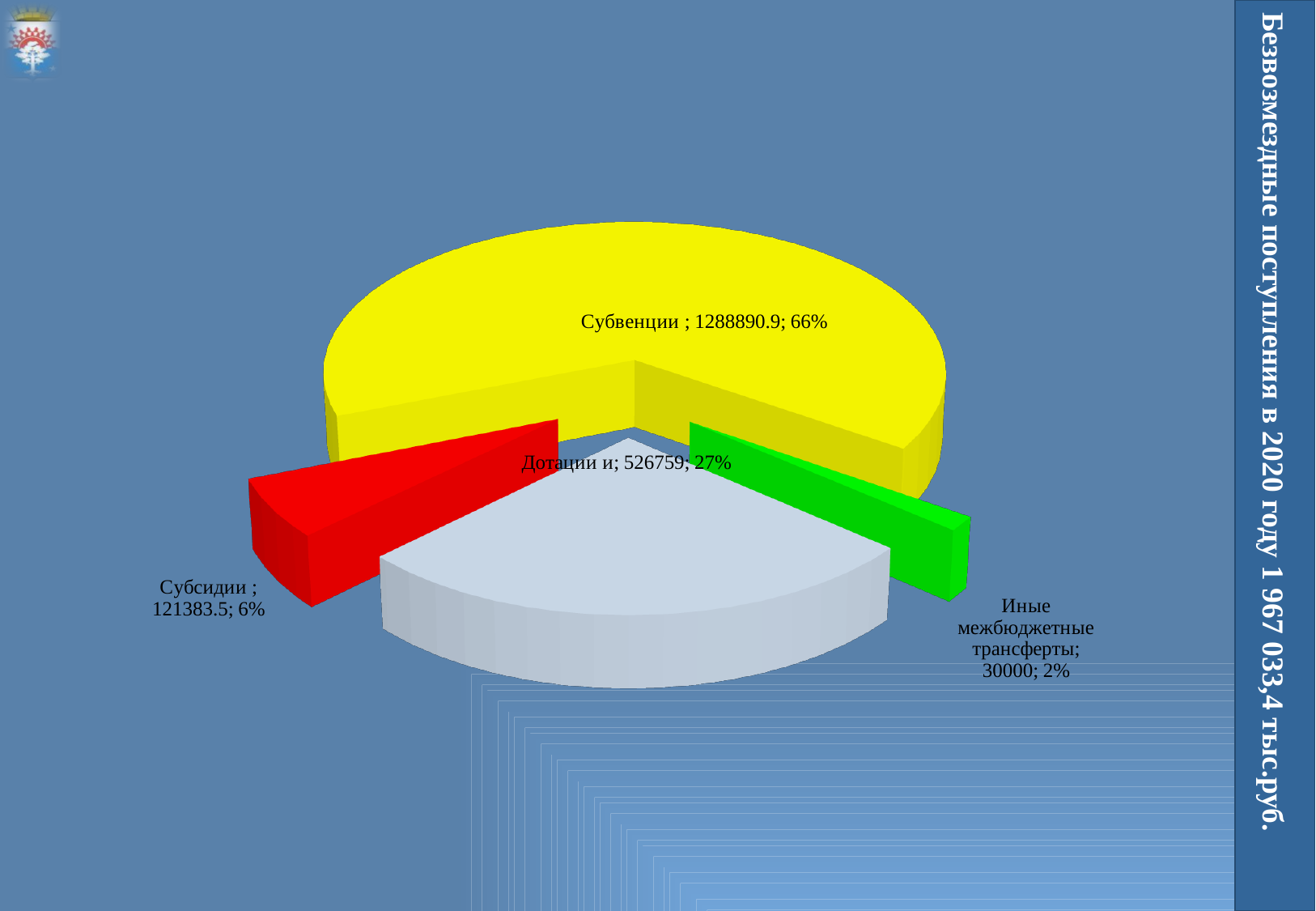
What is the difference between the value for Субсидии and the value for Иные межбюджетные трансферты? 91383.5 How many slices does the pie chart have? 4 Which is larger, the value for Дотации и or the value for Субсидии? Дотации и What colour is the Субвенции slice? Yellow What percentage share does the Субвенции slice have? 66% What is the value shown for Иные межбюджетные трансферты? 30000 What percentage share does the Дотации и slice have? 27% Which category has the smallest share of the pie? Иные межбюджетные трансферты Which category has the largest share of the pie? Субвенции What is the value shown for Субсидии? 121383.5 What kind of chart is shown on the slide? Pie chart What is the value shown for Субвенции? 1288890.9